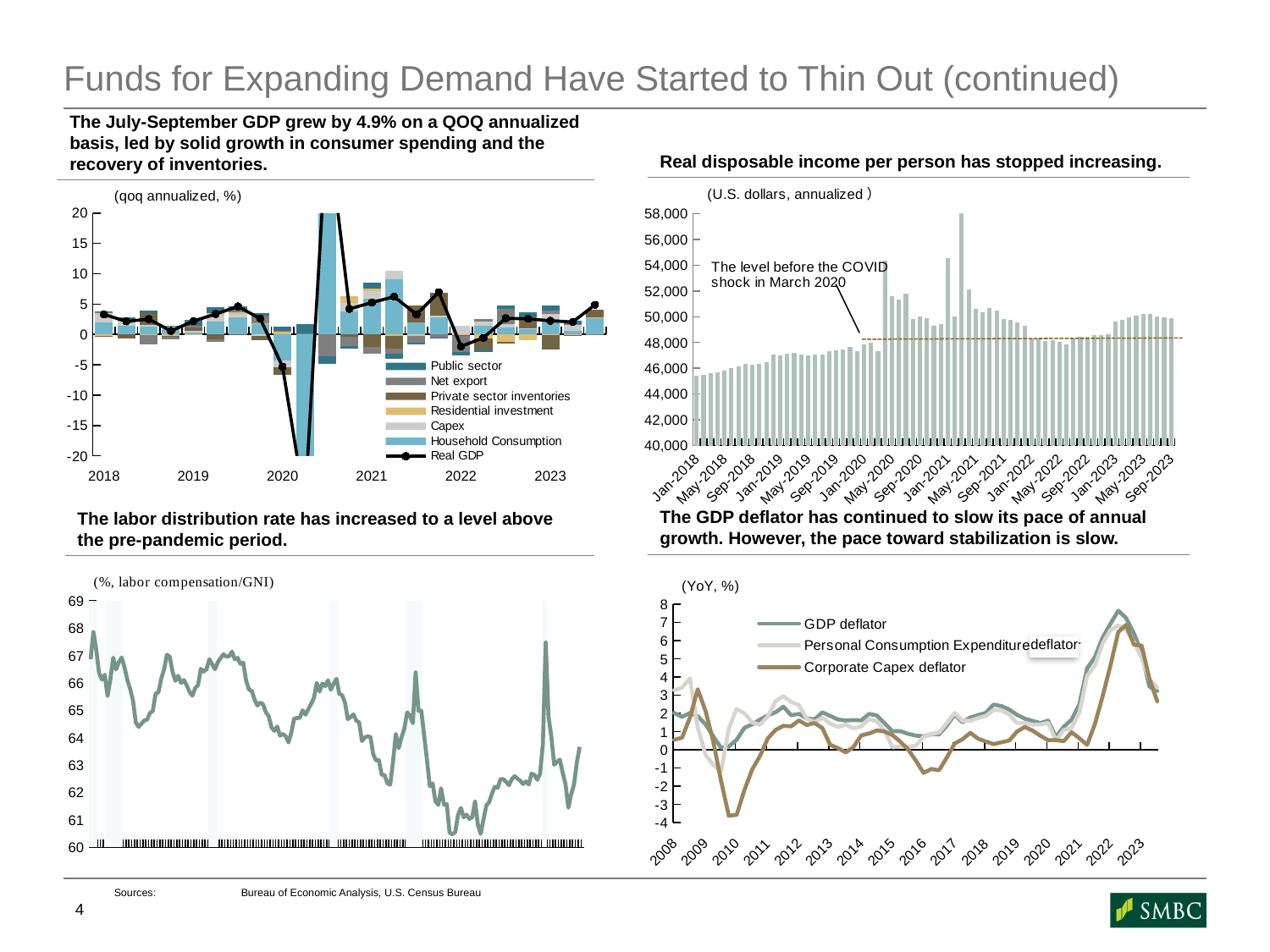
In the top-right chart, do the values rise or fall from Jan-2018 to Jan-2020? rise In the bottom-right chart, which series reaches the lowest value? Corporate Capex deflator What unit label is shown above the bottom-left chart? (%, labor compensation/GNI) How many entries does the legend of the top-left chart (qoq annualized, %) list? 7 In the bottom-right chart, is the lowest value of the Corporate Capex deflator (around 2010) greater or less than -3? less In the bottom-right chart, is the peak of the GDP deflator in 2022 greater or less than 6? greater In the top-right chart, is the highest bar greater or less than 56,000? greater How many series does the legend of the bottom-right chart (YoY, %) list? 3 In the top-left chart, which series is plotted as a line rather than bars? Real GDP What kind of chart is the top-right chart titled 'Real disposable income per person has stopped increasing.'? bar chart